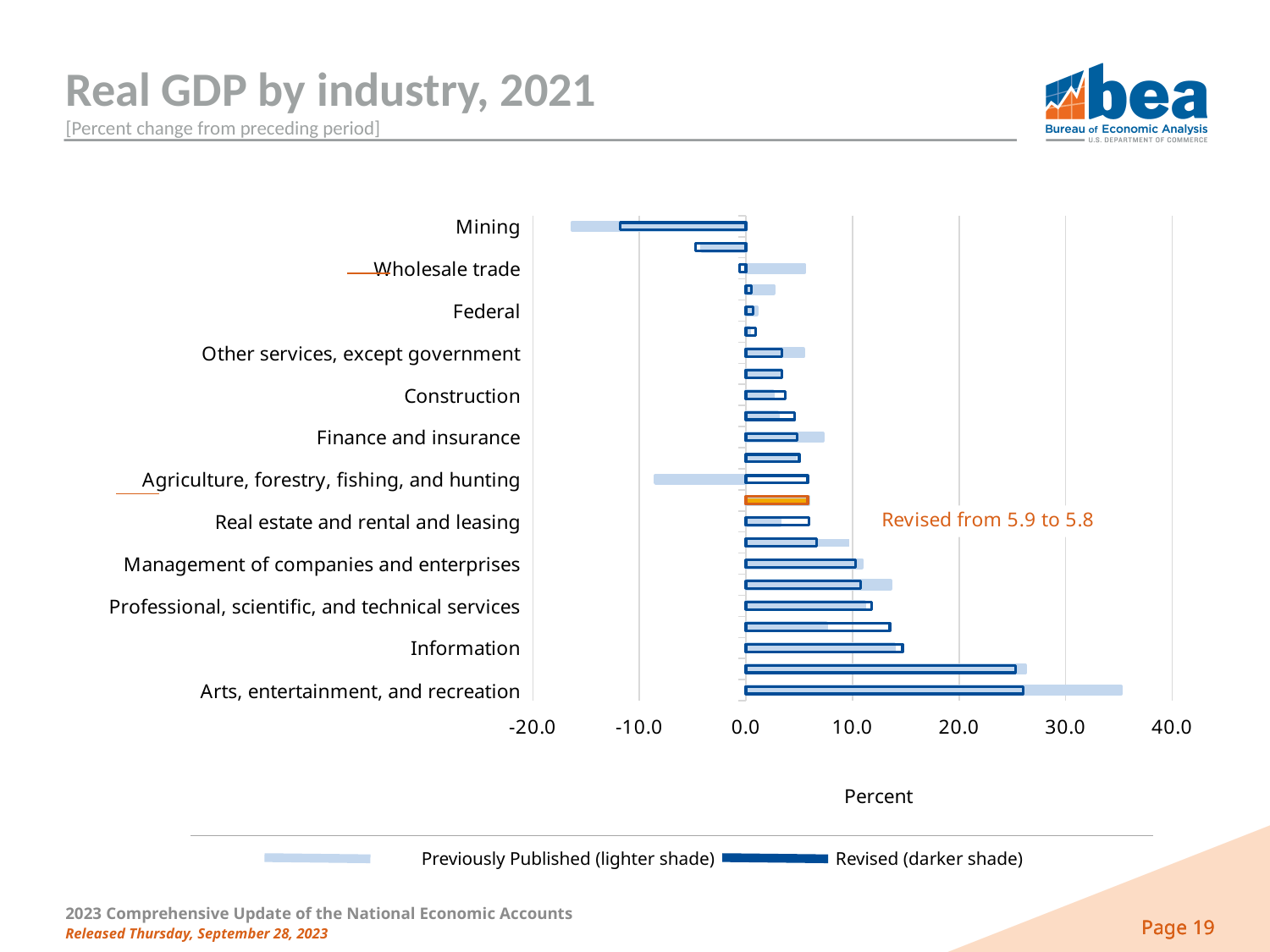
Is the revised value for Information greater or less than 10.0? greater Is the previously published value for Arts, entertainment, and recreation greater or less than 30.0? greater What are the two series named in the legend? Previously Published (lighter shade) and Revised (darker shade) What is the label on the horizontal axis? Percent Is the revised value for Arts, entertainment, and recreation greater or less than 20.0? greater Which labeled industry has the lowest revised value? Mining How many series does the legend list? 2 Which labeled industry has the highest revised value? Arts, entertainment, and recreation What kind of chart is shown on the slide? bar chart Which has the larger revised value, Information or Arts, entertainment, and recreation? Arts, entertainment, and recreation